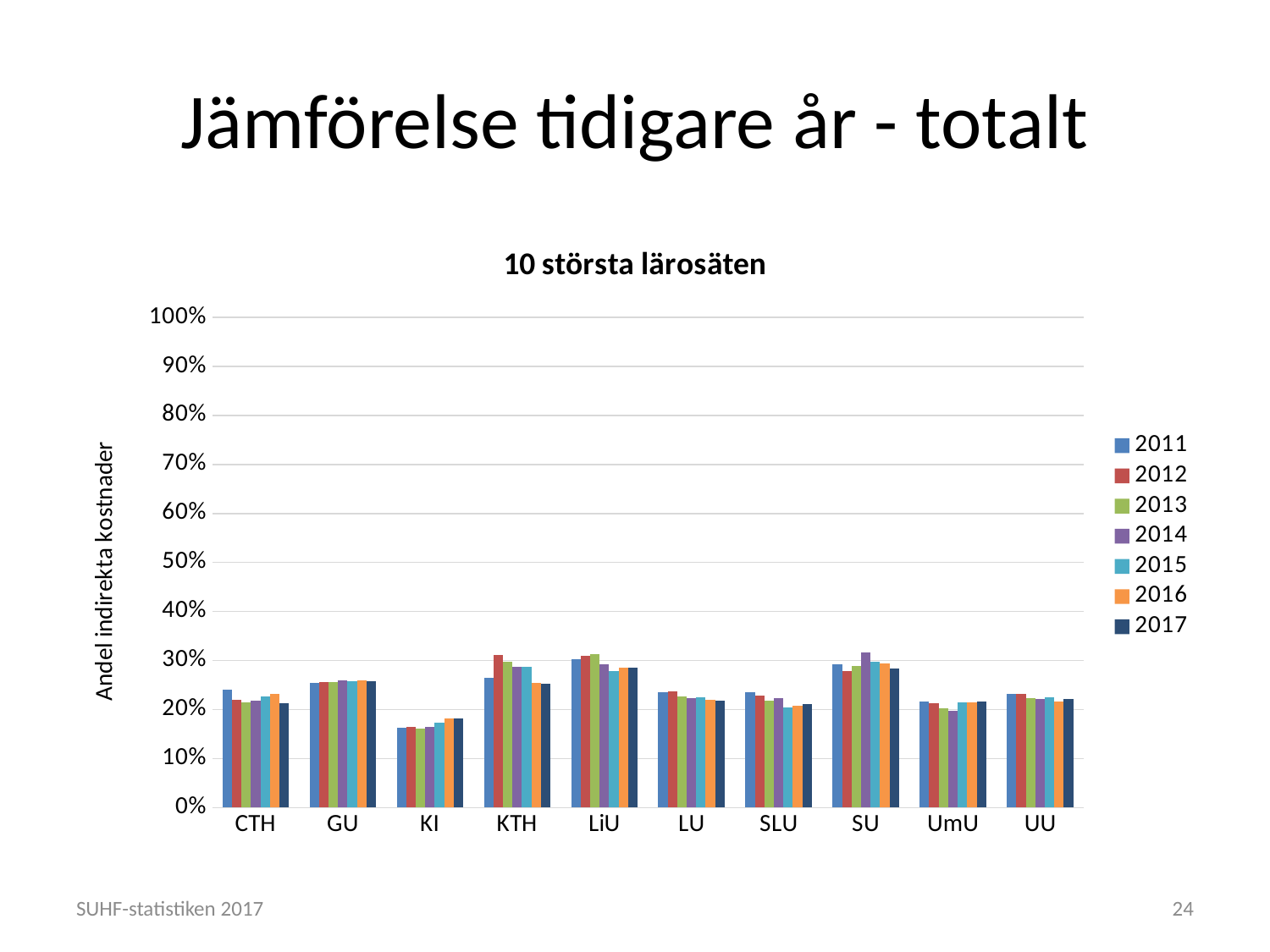
How many institutions (categories) are shown on the x axis of the chart? 10 What kind of chart is shown on the slide? bar chart Is the value for KI in 2011 greater or less than 20%? less What is the label of the vertical axis? Andel indirekta kostnader What is the title of the chart? 10 största lärosäten Is the value for SU in 2014 greater or less than 30%? greater Is the value for GU in 2017 greater or less than 20%? greater Do the values for KTH rise or fall from 2012 to 2017? fall How many series (years) does the legend list? 7 Which is larger, the 2017 value for KI or the 2017 value for KTH? KTH Which institution has the lowest values across all years? KI